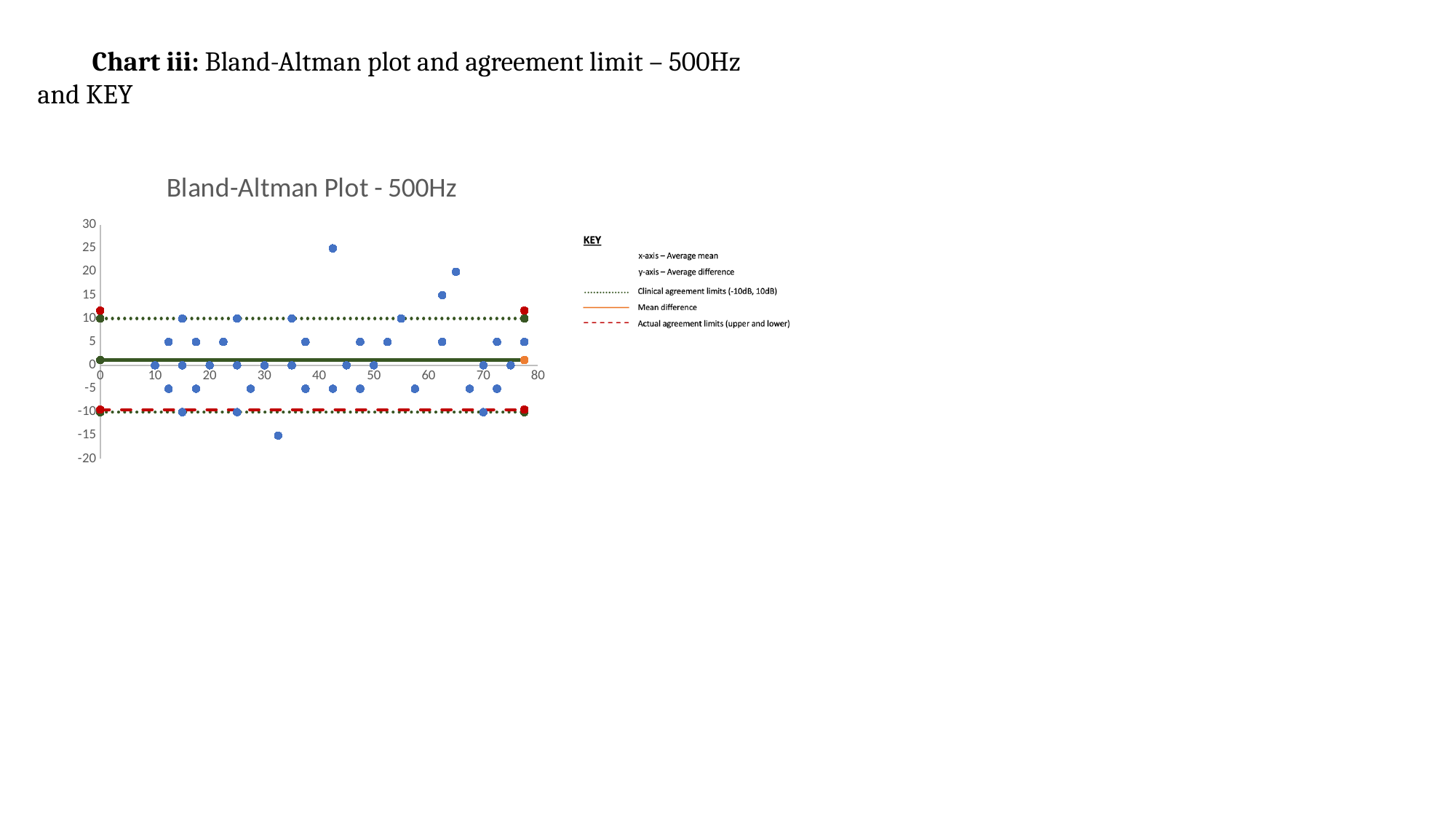
On the Bland-Altman Plot - 500Hz, is the highest plotted point above or below the upper clinical agreement limit of 10? above According to the key, what does the dotted line on the Bland-Altman Plot - 500Hz represent? Clinical agreement limits (-10dB, 10dB) Is the highest plotted point on the Bland-Altman Plot - 500Hz greater or less than 20? greater How many plotted points on the Bland-Altman Plot - 500Hz lie below the lower clinical agreement limit of -10? 1 What is the title of the chart on the slide? Bland-Altman Plot - 500Hz How many plotted points on the Bland-Altman Plot - 500Hz lie above the upper clinical agreement limit of 10? 3 Is the lowest plotted point on the Bland-Altman Plot - 500Hz greater or less than -10? less Is the mean difference line on the Bland-Altman Plot - 500Hz greater or less than 5? less What kind of chart is the Bland-Altman Plot - 500Hz? scatter chart